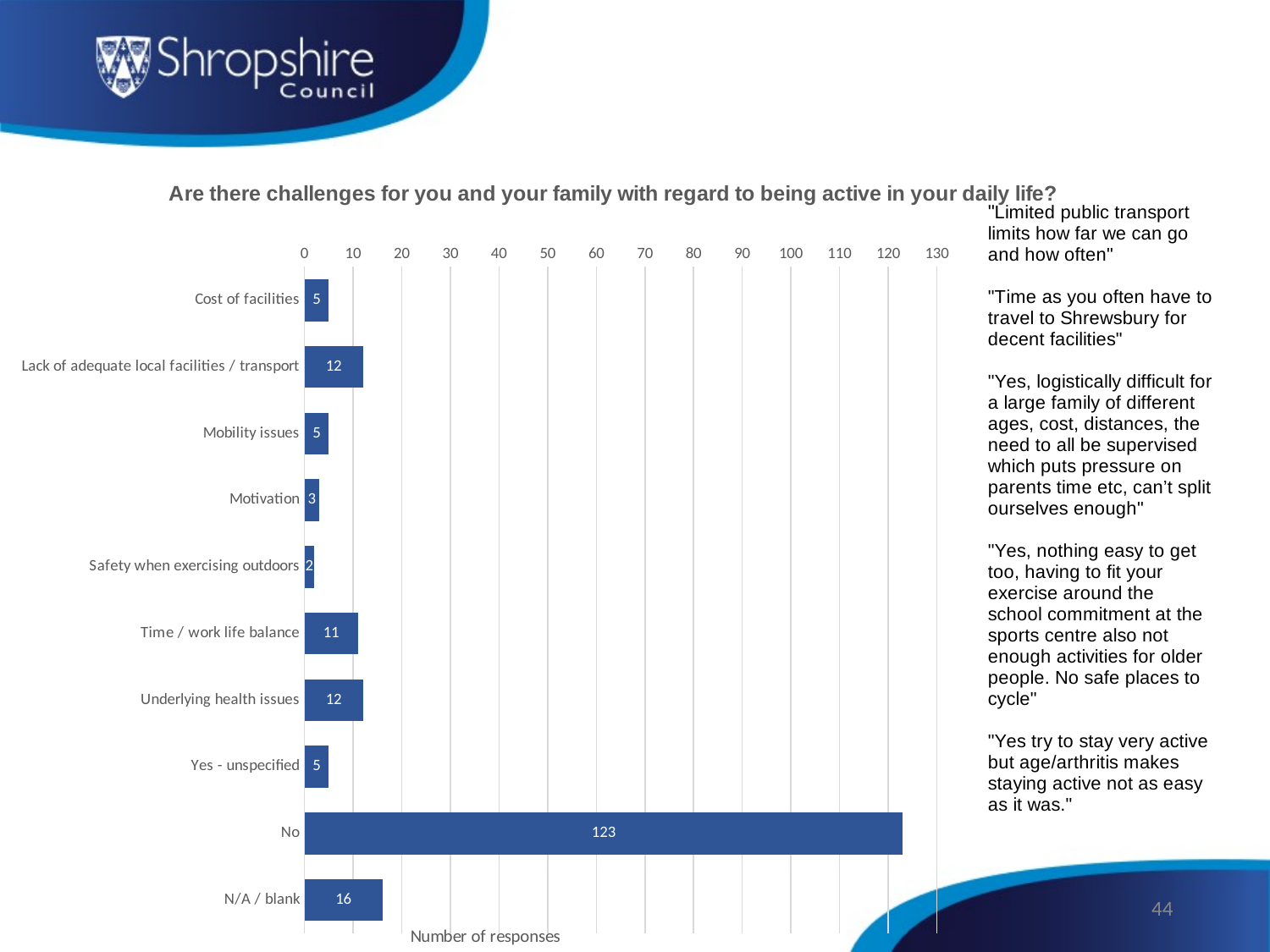
Is the value for 'No' greater or less than 100? greater Which category has the highest number of responses? No Which has more responses, 'Lack of adequate local facilities / transport' or 'Time / work life balance'? Lack of adequate local facilities / transport What is the difference in responses between 'No' and 'N/A / blank'? 107 What is the number of responses for 'Time / work life balance'? 11 What is the difference in responses between 'Underlying health issues' and 'Motivation'? 9 What is the number of responses for 'N/A / blank'? 16 What kind of chart is shown on the slide? bar chart Which category has the lowest number of responses? Safety when exercising outdoors How many categories are shown in the chart? 10 How many responses are there for 'No'? 123 What is the label on the horizontal axis of the chart? Number of responses